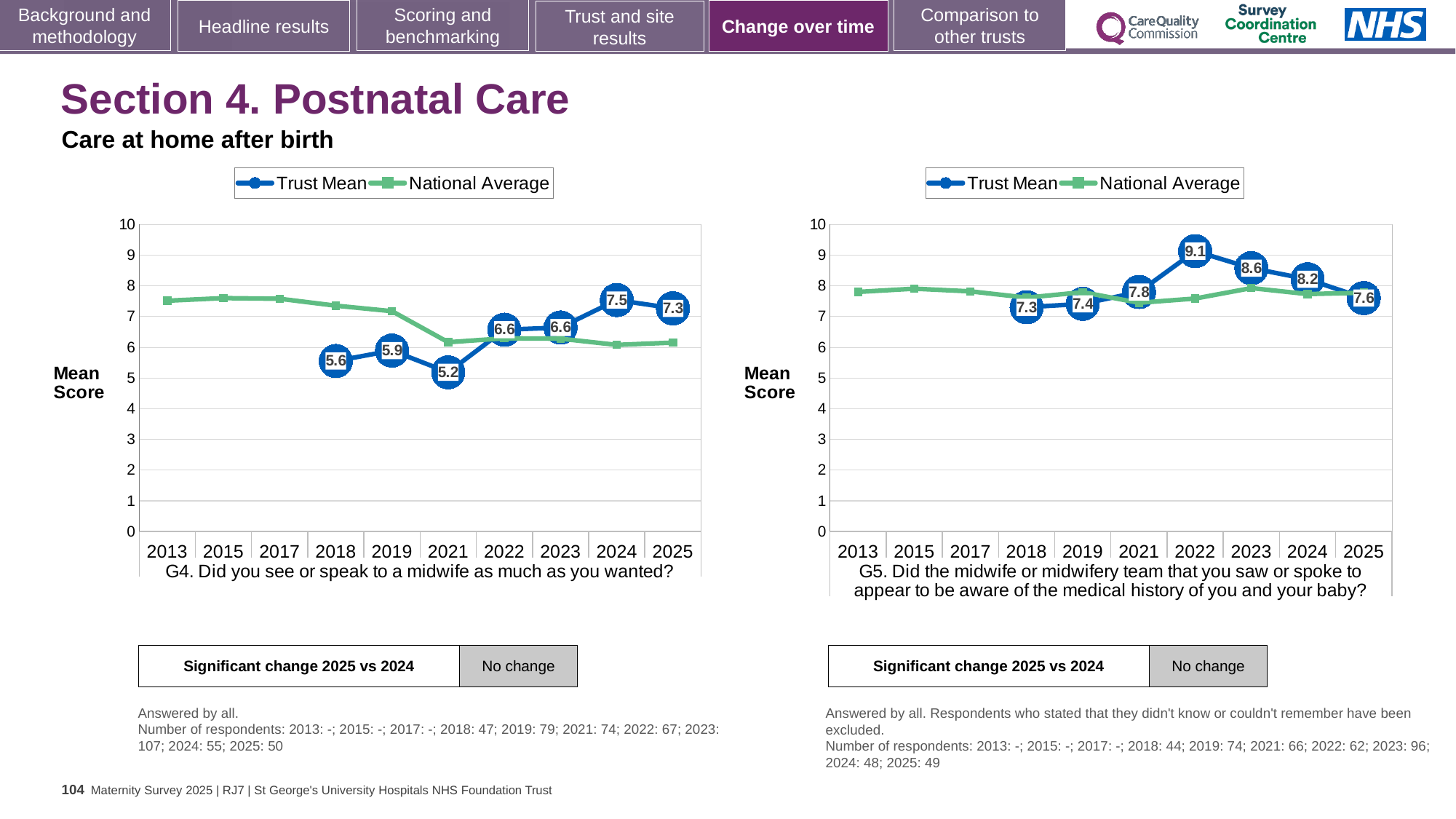
How many series does the legend of the G5 chart list? 2 In the G4 chart, what is the Trust Mean value for 2025? 7.3 In the G5 chart, which year has the highest Trust Mean value? 2022 In the G5 chart, what is the difference between the Trust Mean values for 2022 and 2025? 1.5 In the G4 chart, which year has the lowest Trust Mean value? 2021 In the G4 chart, is the National Average value for 2021 greater or less than 7? less In the G5 chart, is the Trust Mean value for 2023 larger or smaller than the value for 2024? larger What kind of chart is the G4 chart? line chart In the G5 chart, what is the Trust Mean value for 2022? 9.1 In the G4 chart, what is the difference between the Trust Mean values for 2024 and 2018? 1.9 In the G4 chart, what is the Trust Mean value for 2021? 5.2 In the G5 chart, does the Trust Mean rise or fall from 2022 to 2025? fall